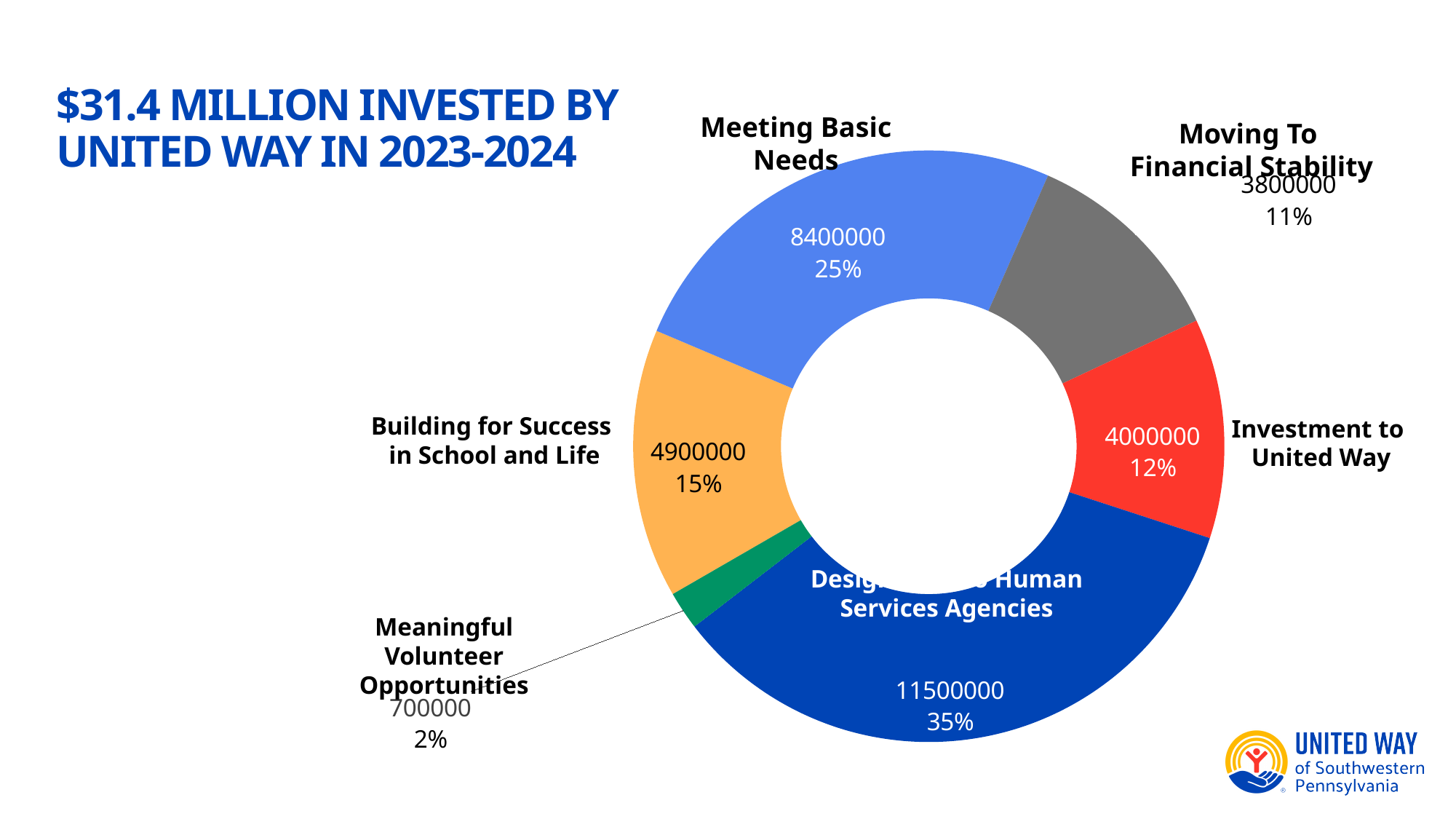
How many categories are shown in the chart? 6 What is the difference between the values for Meeting Basic Needs and Building for Success in School and Life? 3500000 What is the title of the slide? $31.4 MILLION INVESTED BY UNITED WAY IN 2023-2024 What percentage share does Moving To Financial Stability have? 11% Which category has the smallest share of the chart? Meaningful Volunteer Opportunities What is the value for Investment to United Way? 4000000 Which is larger, the value for Investment to United Way or the value for Moving To Financial Stability? Investment to United Way What is the value for Meeting Basic Needs? 8400000 What percentage share does Building for Success in School and Life have? 15% What kind of chart is shown on the slide? Pie chart (donut) Which category has the largest share of the chart? Designation to Human Services Agencies What is the value for Meaningful Volunteer Opportunities? 700000